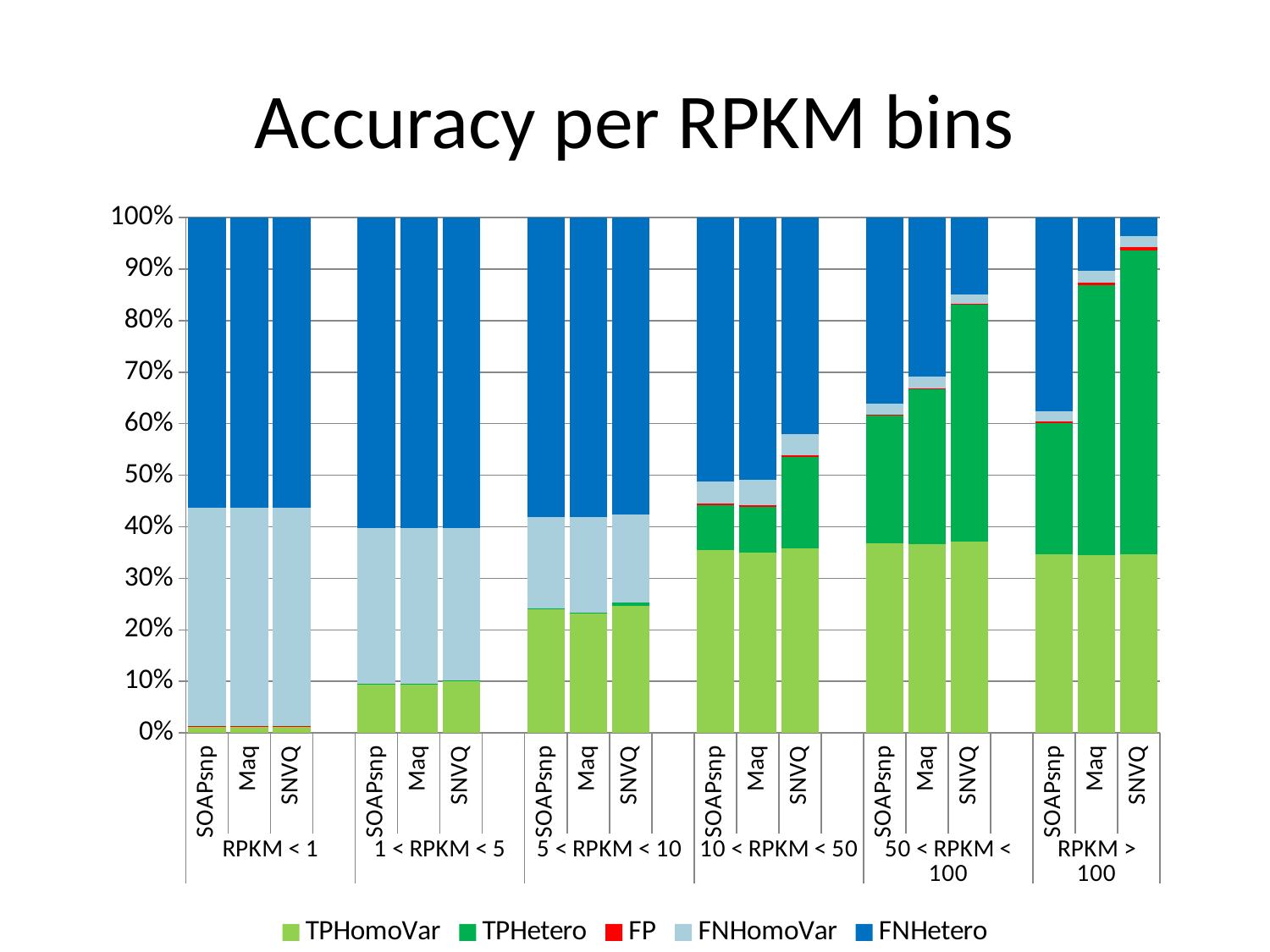
How many bars are plotted in total on the chart? 18 Is the combined TPHomoVar and TPHetero share for SNVQ in the RPKM > 100 bin greater or less than 90%? greater What kind of chart is shown on the slide? Stacked bar chart How many RPKM bins are shown along the x axis? 6 In the 50 < RPKM < 100 bin, which tool has the largest TPHetero segment? SNVQ Is the TPHomoVar share for SOAPsnp in the 5 < RPKM < 10 bin greater or less than 20%? greater Is the TPHomoVar share for SNVQ in the 10 < RPKM < 50 bin greater or less than 30%? greater How many series does the legend list? 5 What is the title of the chart? Accuracy per RPKM bins In the RPKM > 100 bin, which tool has the smallest FNHetero segment? SNVQ Which colour represents the FP series in the legend? Red Does the FNHetero share for SNVQ rise or fall as the RPKM bins increase from left to right? Fall